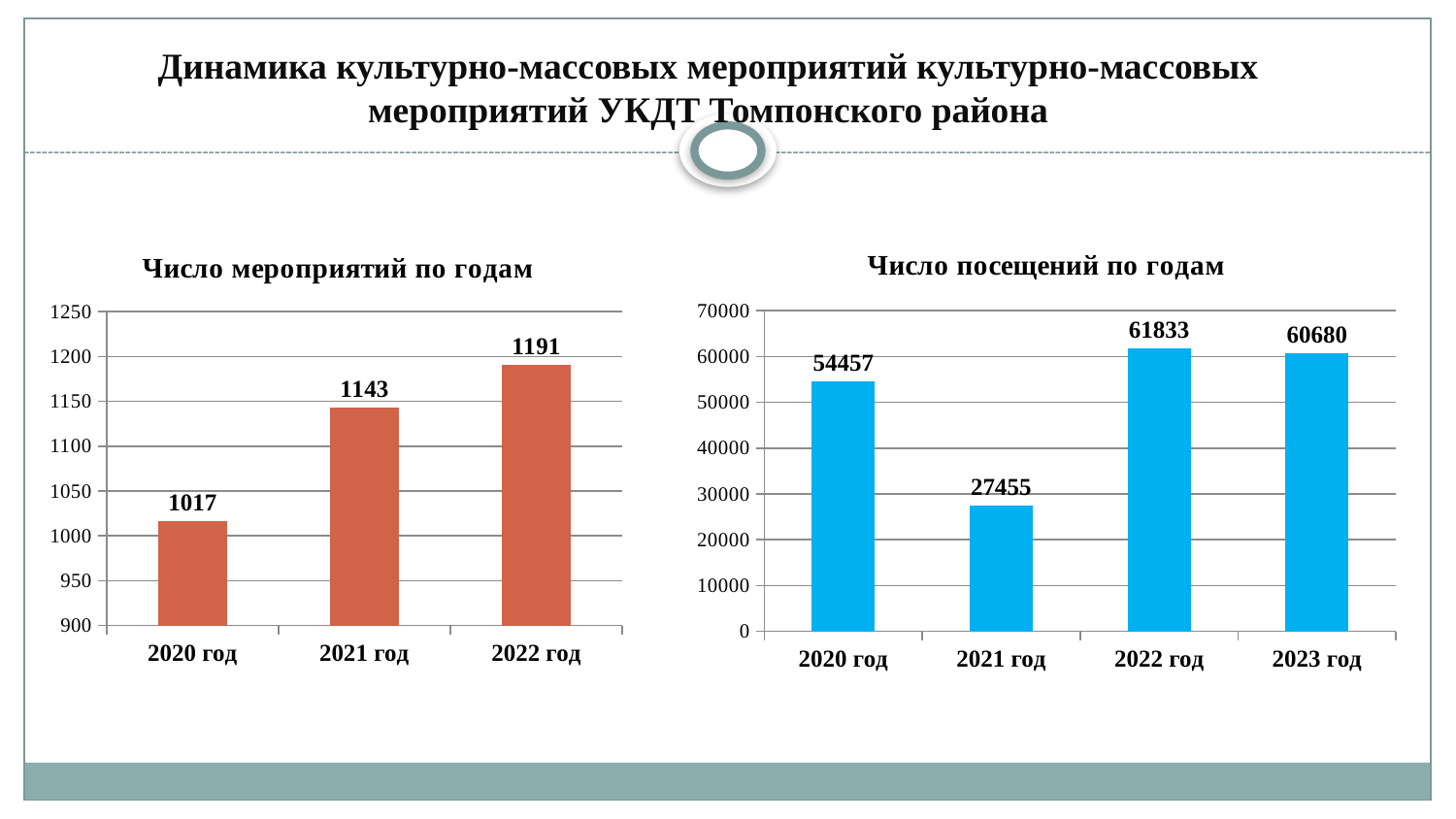
What kind of chart is 'Число мероприятий по годам'? bar chart In the chart 'Число посещений по годам', which is larger: the value for 2020 год or the value for 2021 год? 2020 год In the chart 'Число мероприятий по годам', is the value for 2020 год greater or less than 1050? less In the chart 'Число мероприятий по годам', what is the value for 2021 год? 1143 How many years are shown in the chart 'Число мероприятий по годам'? 3 In the chart 'Число посещений по годам', what is the difference between the values for 2022 год and 2023 год? 1153 In the chart 'Число мероприятий по годам', what is the difference between the values for 2022 год and 2020 год? 174 In the chart 'Число посещений по годам', what is the value for 2021 год? 27455 In the chart 'Число мероприятий по годам', do the values rise or fall from 2020 год to 2022 год? rise How many years are shown in the chart 'Число посещений по годам'? 4 In the chart 'Число посещений по годам', which year has the lowest value? 2021 год In the chart 'Число мероприятий по годам', which year has the highest value? 2022 год